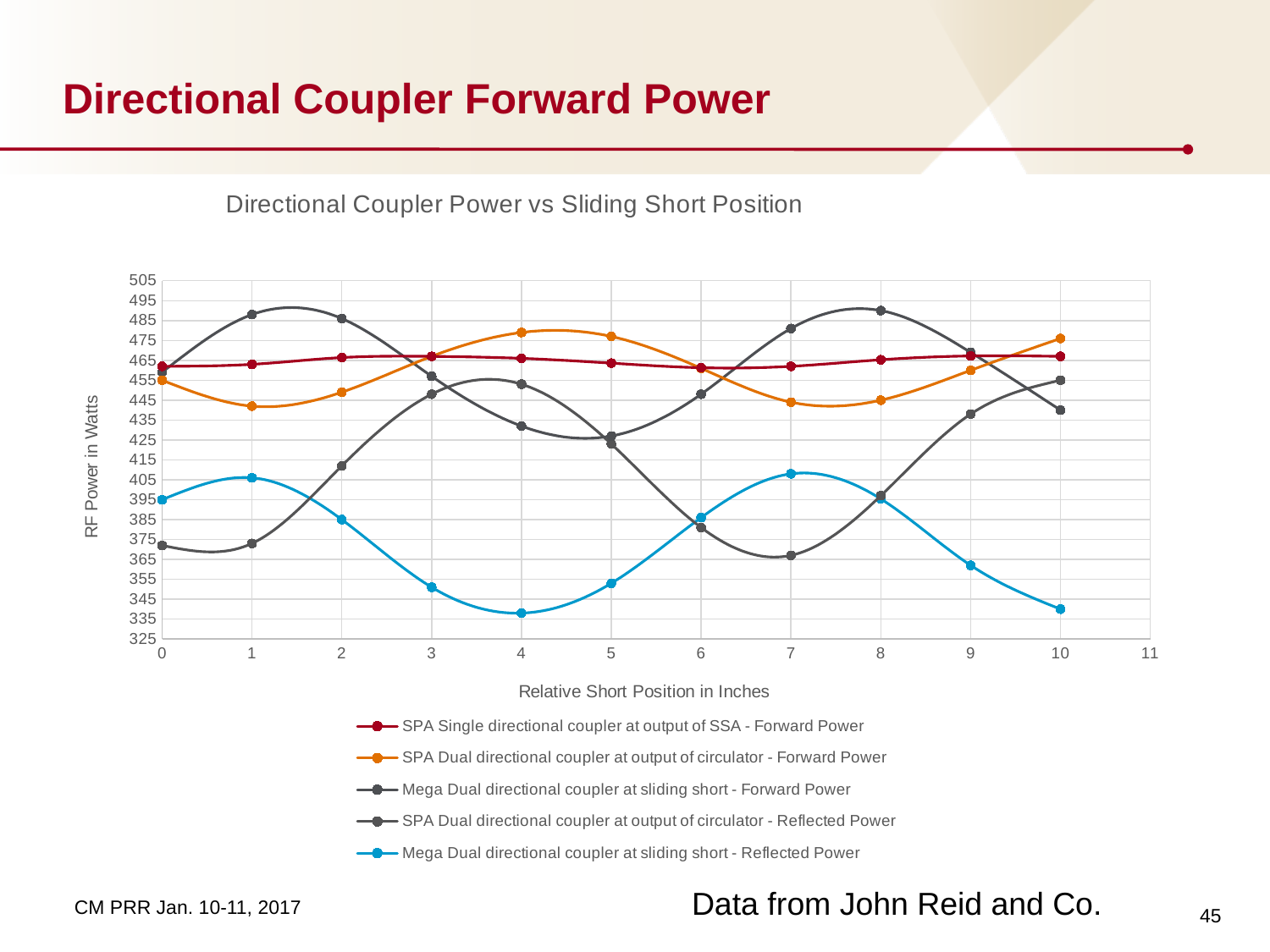
Is the value for SPA Dual directional coupler at output of circulator - Forward Power at position 1 greater or less than 455? less How many series does the legend list? 5 At position 1, which is larger: SPA Single directional coupler at output of SSA - Forward Power or SPA Dual directional coupler at output of circulator - Forward Power? SPA Single directional coupler at output of SSA - Forward Power What kind of chart is shown on the slide? line chart Is the value for Mega Dual directional coupler at sliding short - Reflected Power at position 4 greater or less than 355? less Is the value for SPA Single directional coupler at output of SSA - Forward Power at position 0 greater or less than 455? greater What is the label on the y axis of the chart? RF Power in Watts How many data points are plotted for the SPA Single directional coupler at output of SSA - Forward Power series? 11 Which series has the highest value at position 4? SPA Dual directional coupler at output of circulator - Forward Power Does the Mega Dual directional coupler at sliding short - Reflected Power series rise or fall from position 1 to position 4? fall Which series has the lowest value at position 4? Mega Dual directional coupler at sliding short - Reflected Power